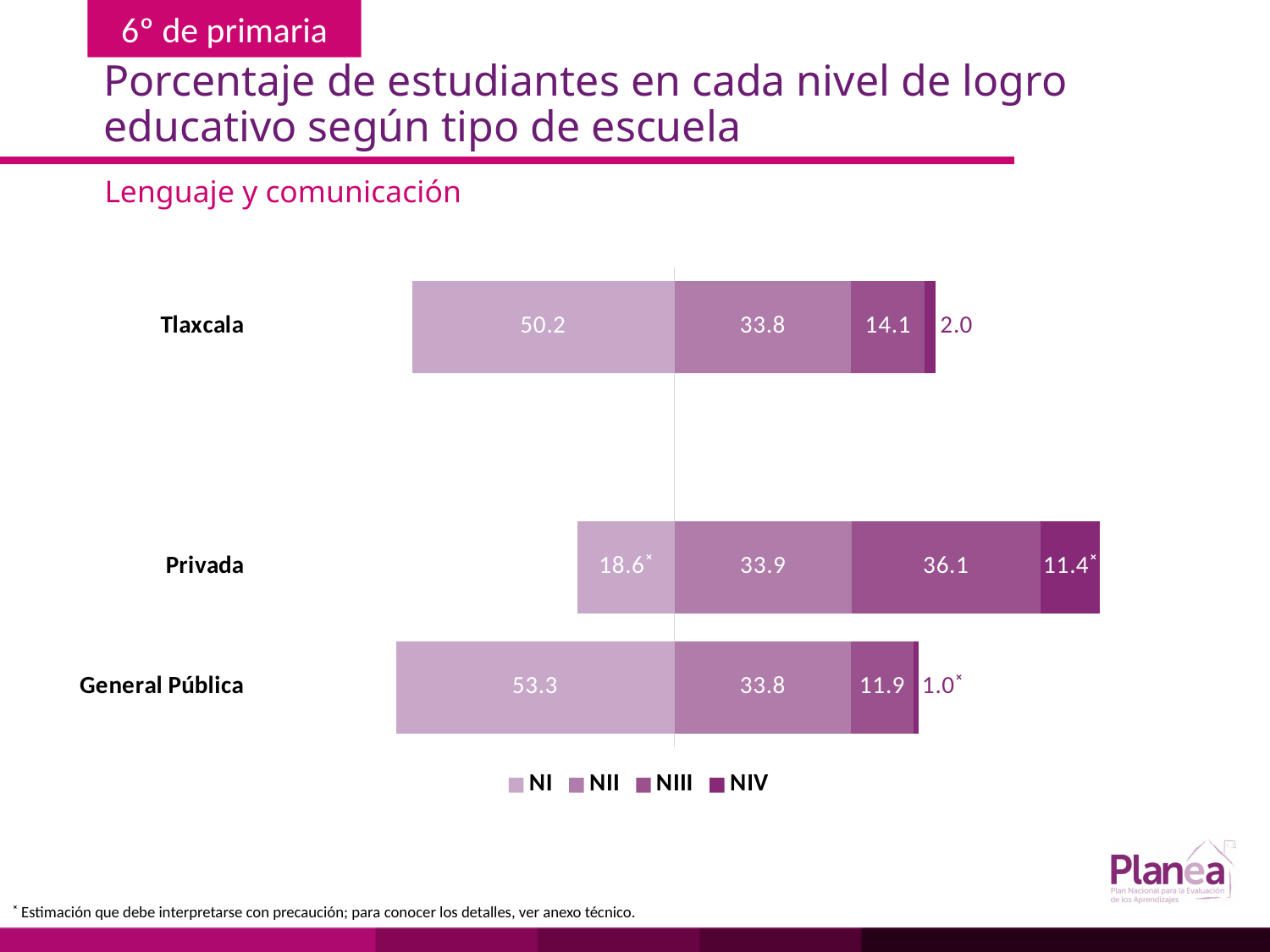
Which is larger, the NIII value for Tlaxcala or the NIII value for General Pública? Tlaxcala What is the NI value for Tlaxcala? 50.2 How many school types (categories) are shown in the chart? 3 What is the NII value for Privada? 33.9 What is the NIV value for General Pública? 1.0 Which school type has the highest NI value? General Pública How many series does the legend list? 4 Which school type has the lowest NIV value? General Pública What is the NIII value for Privada? 36.1 What is the difference between the NI values for General Pública and Privada? 34.7 What kind of chart is shown on the slide? Stacked bar chart What is the total of the stacked bar for Privada? 100.0